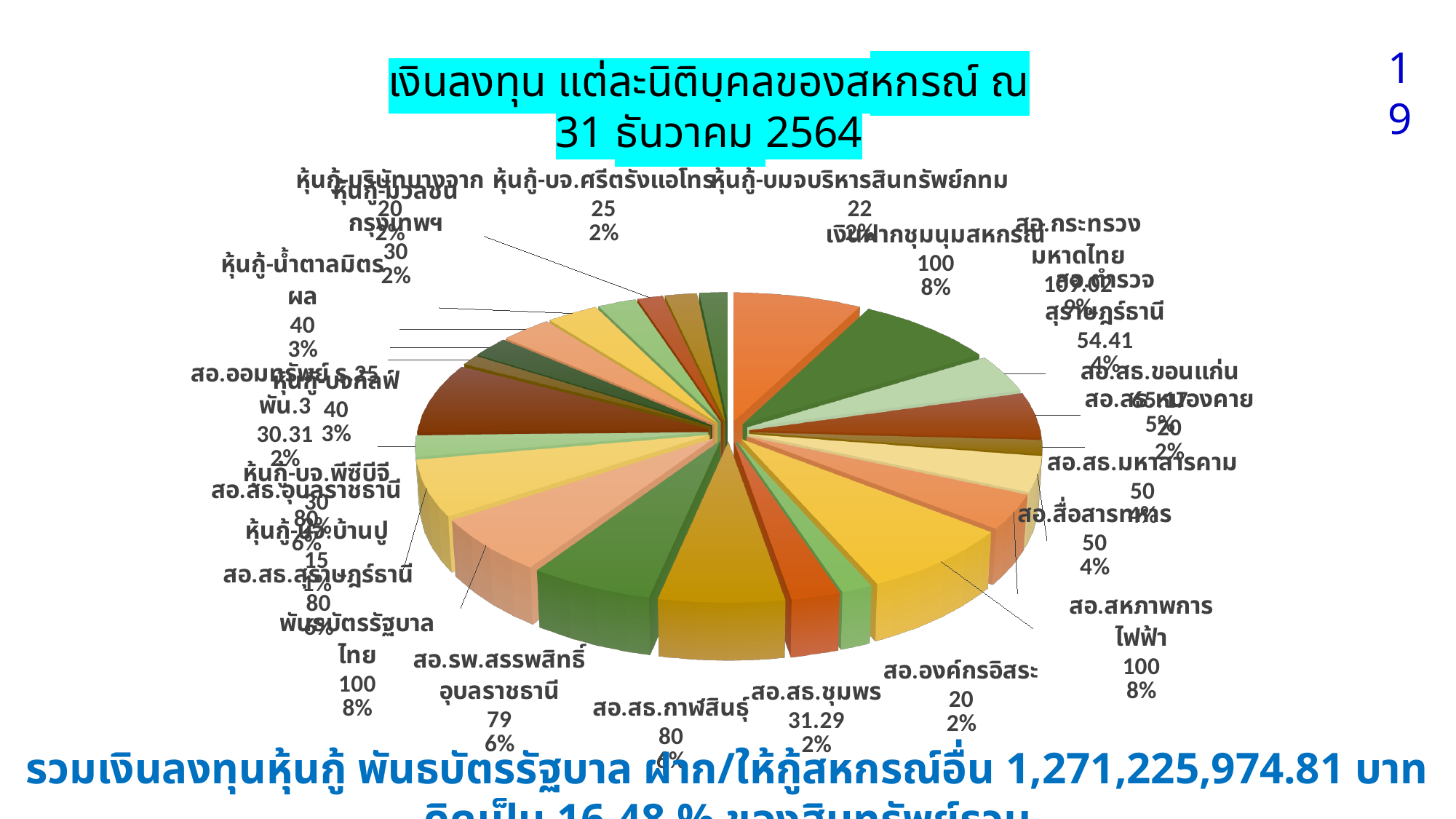
What share of the pie does พันธบัตรรัฐบาลไทย represent? 8% What is the value shown for สอ.ตำรวจสุราษฎร์ธานี? 54.41 What is the value shown for เงินฝากชุมนุมสหกรณ์? 100 What is the value shown for หุ้นกู้-บจ.ศรีตรังแอโกร? 25 Which category has the smallest value in the pie chart? หุ้นกู้-บจ.บ้านปู What share of the pie does สอ.สธ.กาฬสินธุ์ represent? 6% What is the value shown for สอ.สธ.ชุมพร? 31.29 Which is larger, the value for สอ.สธ.ขอนแก่น or the value for สอ.สธ.มหาสารคาม? สอ.สธ.ขอนแก่น What is the title of the chart? เงินลงทุน แต่ละนิติบุคลของสหกรณ์ ณ 31 ธันวาคม 2564 What is the difference between the value for สอ.รพ.สรรพสิทธิ์อุบลราชธานี and the value for สอ.องค์กรอิสระ? 59 What kind of chart is shown on the slide? pie chart What share of the pie does สอ.สหภาพการไฟฟ้า represent? 8%